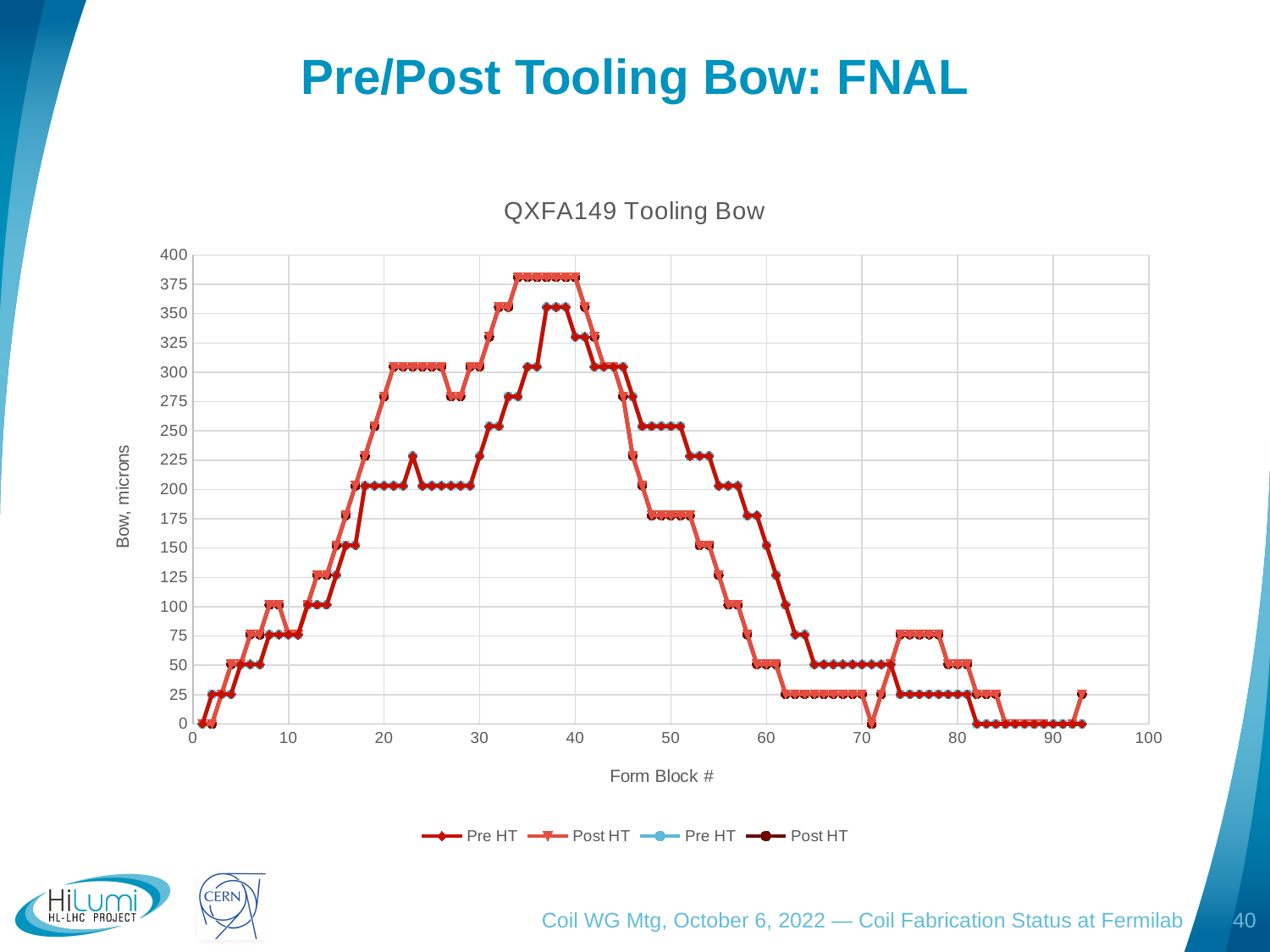
What is the label of the y axis? Bow, microns How many series does the chart legend list? 4 Do the plotted values rise or fall between form block 45 and form block 65? fall Is the value of the red Pre HT line at form block 40 greater or less than 350? less Is the value of the dark Post HT line at form block 90 greater or less than 25? less Do the plotted values rise or fall between form block 0 and form block 35? rise Is the value of the red Pre HT line at form block 20 greater or less than 250? less What is the title of the chart? QXFA149 Tooling Bow What kind of chart is shown on the slide? line chart